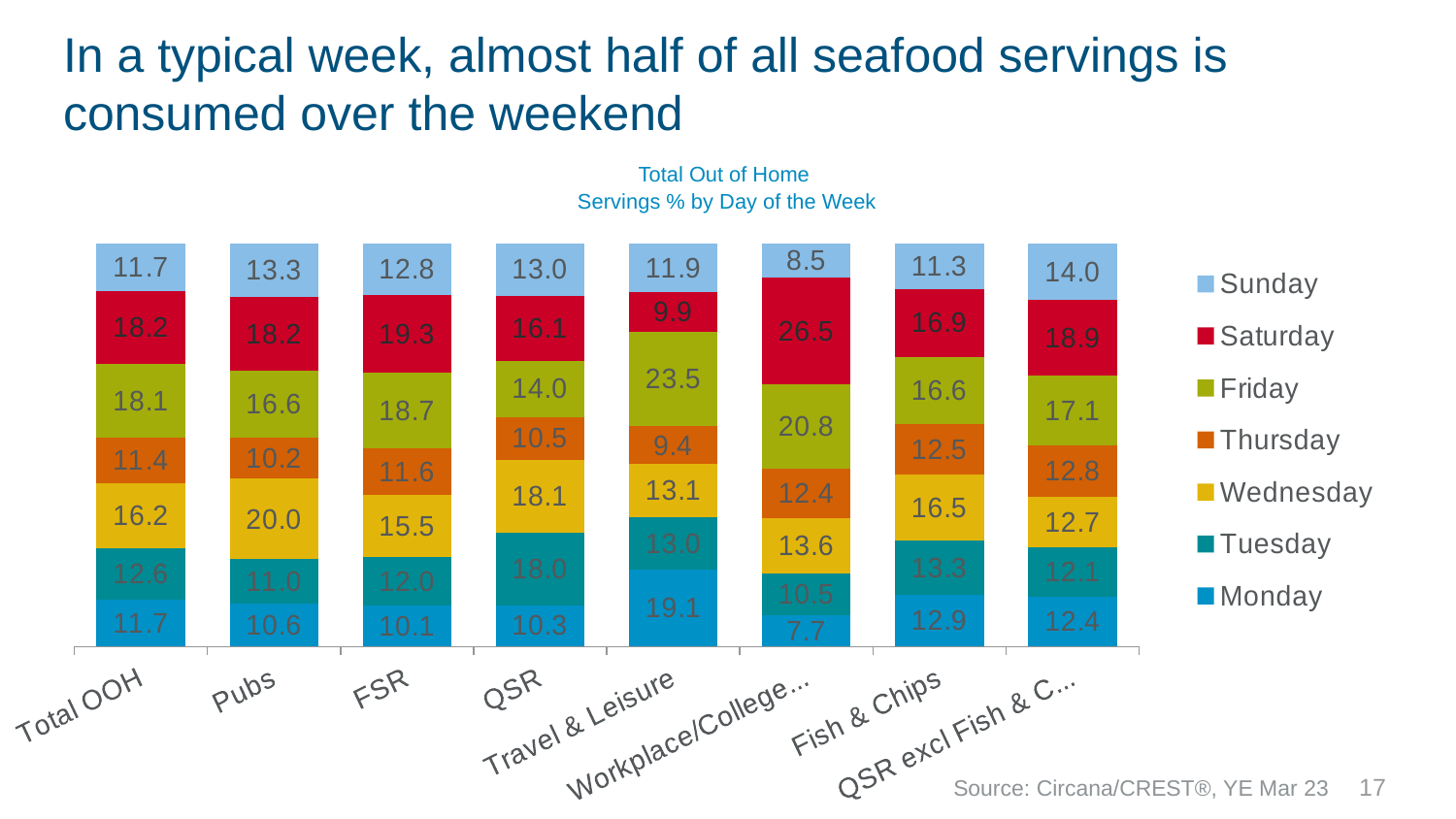
Which has the larger Wednesday value, Pubs or QSR? Pubs How many series does the legend list? 7 How many categories are shown on the x axis? 8 Which category has the highest Friday value? Travel & Leisure What is the difference between the Saturday and Thursday values for Total OOH? 6.8 Which day has the lowest value for Pubs? Thursday What kind of chart is shown on the slide? Stacked bar chart What is the Friday value for FSR? 18.7 What is the total of the Fish & Chips bar? 100.0 What is the Saturday value for Pubs? 18.2 What is the Monday value for Travel & Leisure? 19.1 What is the Tuesday value for QSR? 18.0